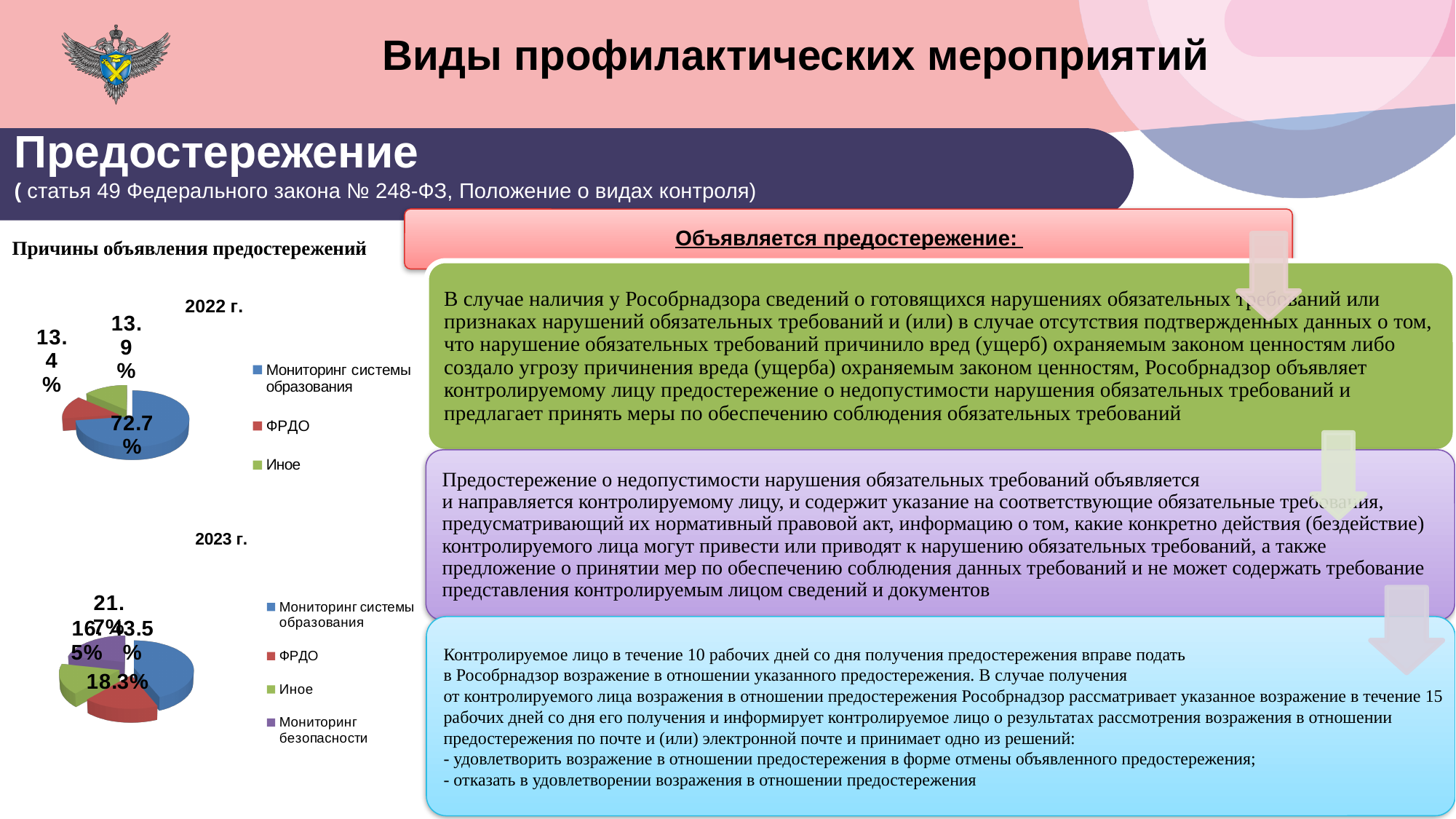
In the 2022 г. pie chart, what share is shown for Мониторинг системы образования? 72.7% How many categories does the legend of the 2023 г. chart list? 4 How many categories does the legend of the 2022 г. chart list? 3 In the 2023 г. pie chart, which category has the largest share? Мониторинг системы образования What is the heading above the two pie charts? Причины объявления предостережений In the 2023 г. pie chart, what share is shown for Мониторинг системы образования? 43.5% What type of chart is used for the 2022 г. data? Pie chart In the 2023 г. pie chart, which is larger: Мониторинг системы образования or ФРДО? Мониторинг системы образования In the 2023 г. pie chart, what share is shown for ФРДО? 18.3% In the 2023 г. pie chart, what is the difference between the shares of Мониторинг системы образования and ФРДО? 25.2 percentage points In the 2022 г. pie chart, which category has the largest share? Мониторинг системы образования Which legend category appears in the 2023 г. chart but not in the 2022 г. chart? Мониторинг безопасности